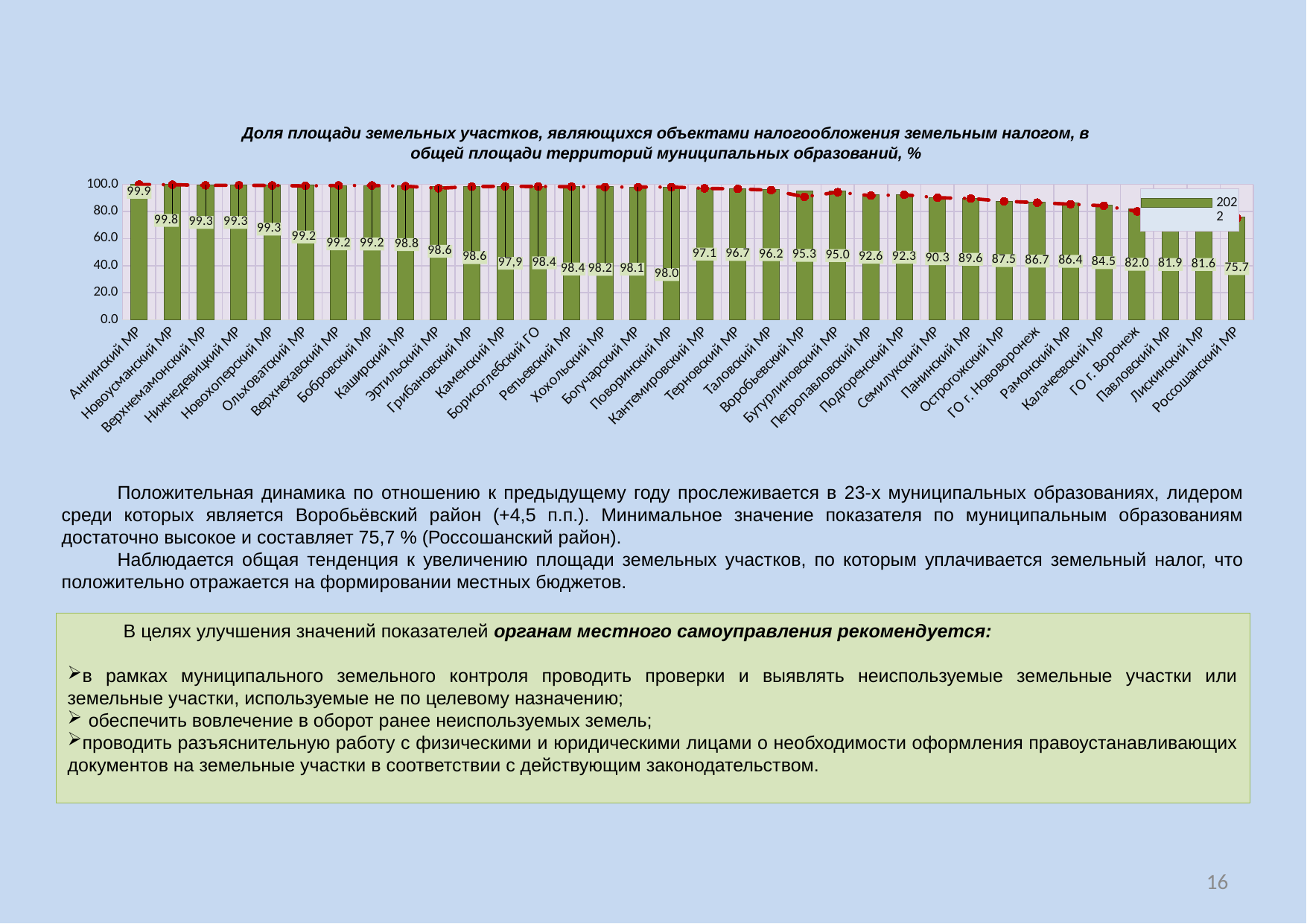
What is the difference between the values for Аннинский МР and Россошанский МР? 24.2 What is the value for ГО г. Воронеж? 82.0 Is the value for Россошанский МР greater or less than 80? less What is the value for Аннинский МР? 99.9 Which is larger, the value for Воробьевский МР or for Семилукский МР? Воробьевский МР Do the values rise or fall from left to right along the x axis? fall Which municipality has the highest value on the chart? Аннинский МР What is the value for Россошанский МР? 75.7 What kind of chart is shown on the slide? combination bar and line chart What is the value for Калачеевский МР? 84.5 Which municipality has the lowest value on the chart? Россошанский МР What unit is indicated at the end of the chart title? %